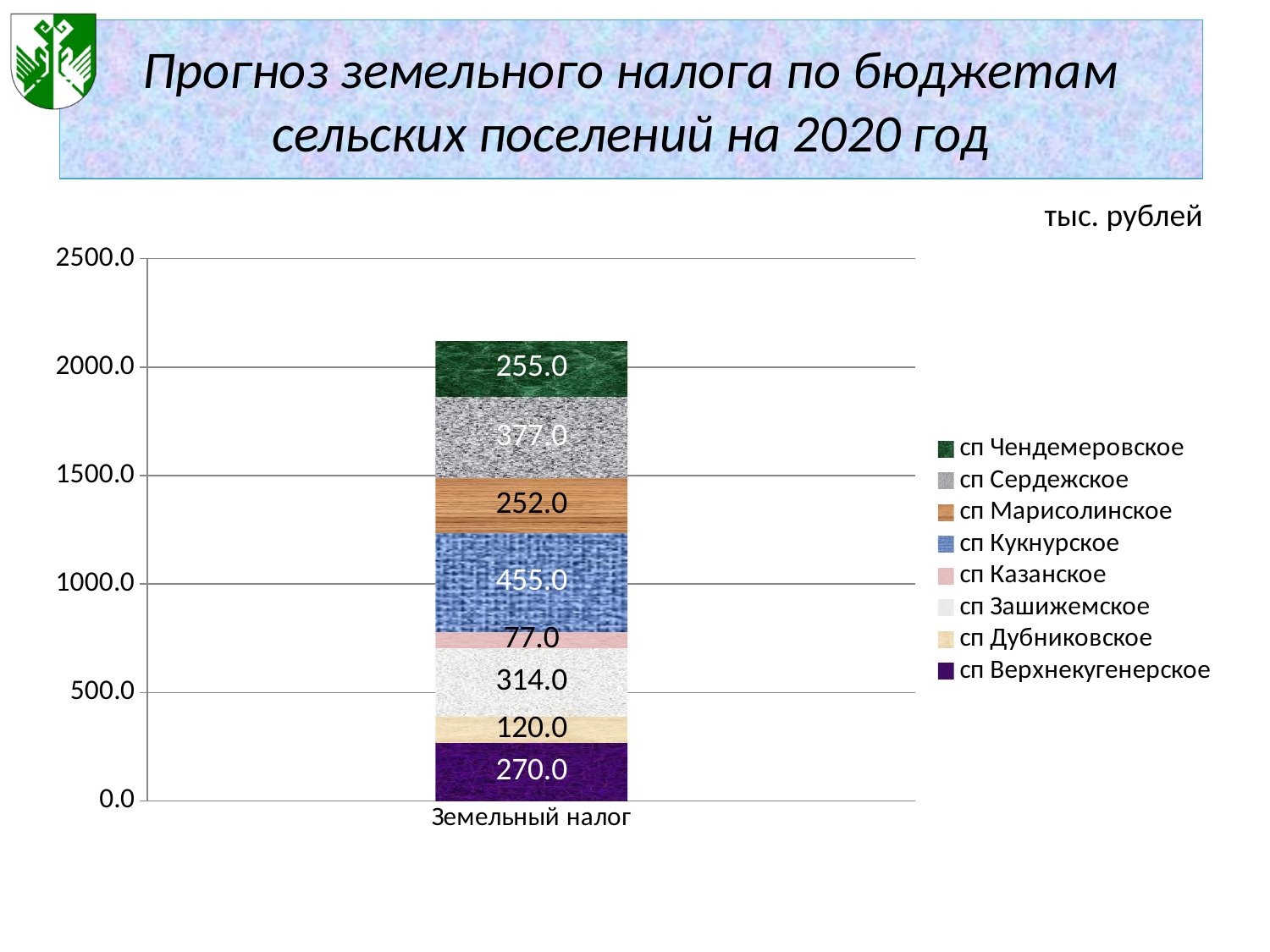
What unit is indicated above the chart? тыс. рублей Which settlement has the highest land tax forecast? сп Кукнурское What is the value for сп Казанское? 77.0 What is the value for сп Кукнурское? 455.0 What is the difference between the values for сп Сердежское and сп Чендемеровское? 122.0 Which is larger, the value for сп Верхнекугенерское or сп Дубниковское? сп Верхнекугенерское What is the total of the stacked bar for Земельный налог? 2120.0 How many series does the legend list? 8 Which settlement has the lowest land tax forecast? сп Казанское What is the value for сп Верхнекугенерское? 270.0 What type of chart is shown on the slide? stacked bar chart Is the total height of the stacked bar greater or less than 2000.0? greater